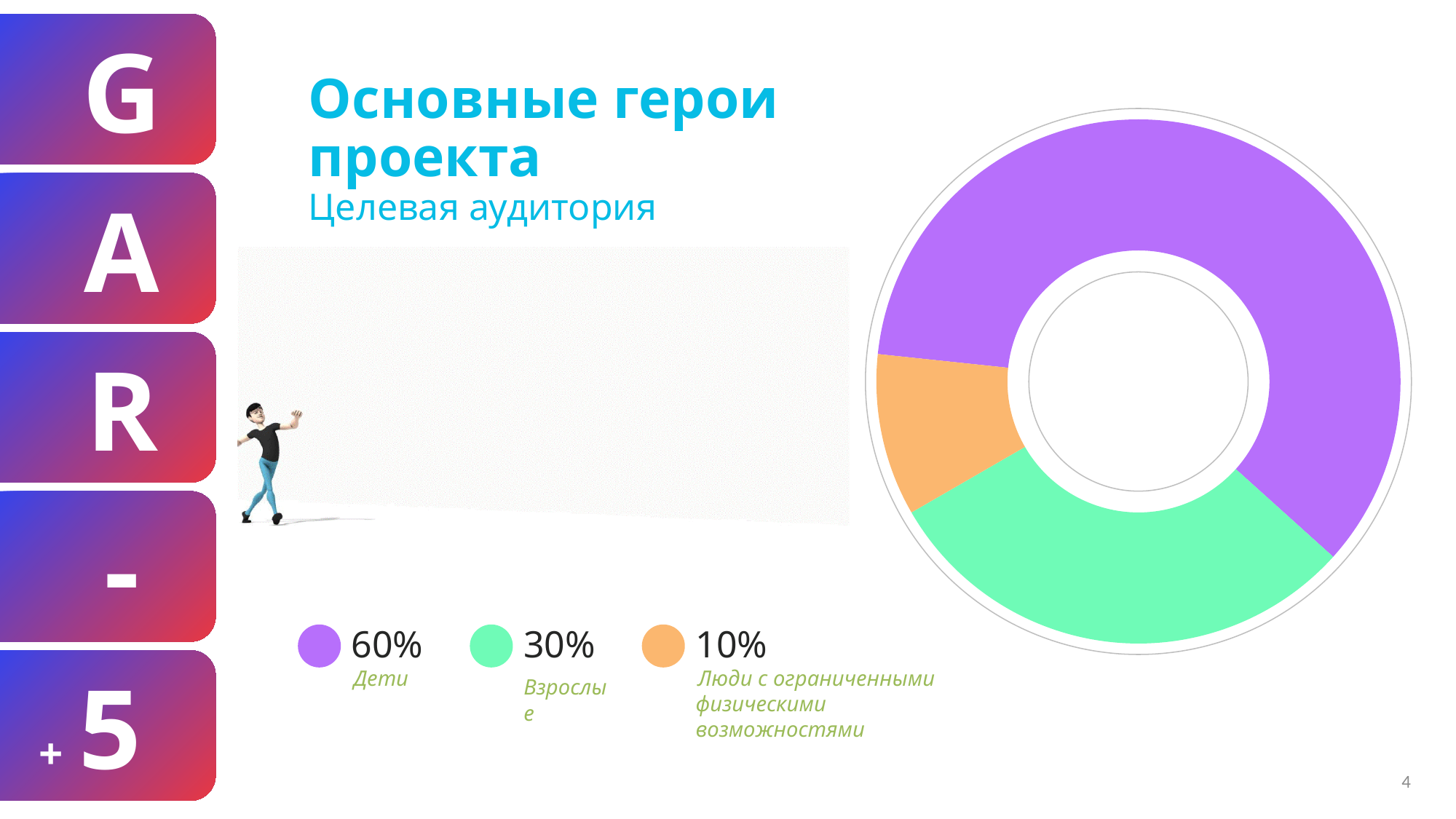
Which is larger, the share for Взрослые or the share for Люди с ограниченными физическими возможностями? Взрослые Which category has the smallest share of the chart? Люди с ограниченными физическими возможностями What share of the chart is labelled Дети? 60% What is the difference between the shares for Дети and Взрослые? 30% What colour is the segment for Взрослые? Green How many segments does the donut chart have? 3 What colour is the segment for Дети? Purple Which category has the largest share of the chart? Дети What share of the chart is labelled Взрослые? 30% What kind of chart is shown on the slide? Pie (donut) chart What is the combined share of Взрослые and Люди с ограниченными физическими возможностями? 40% What share of the chart is labelled Люди с ограниченными физическими возможностями? 10%